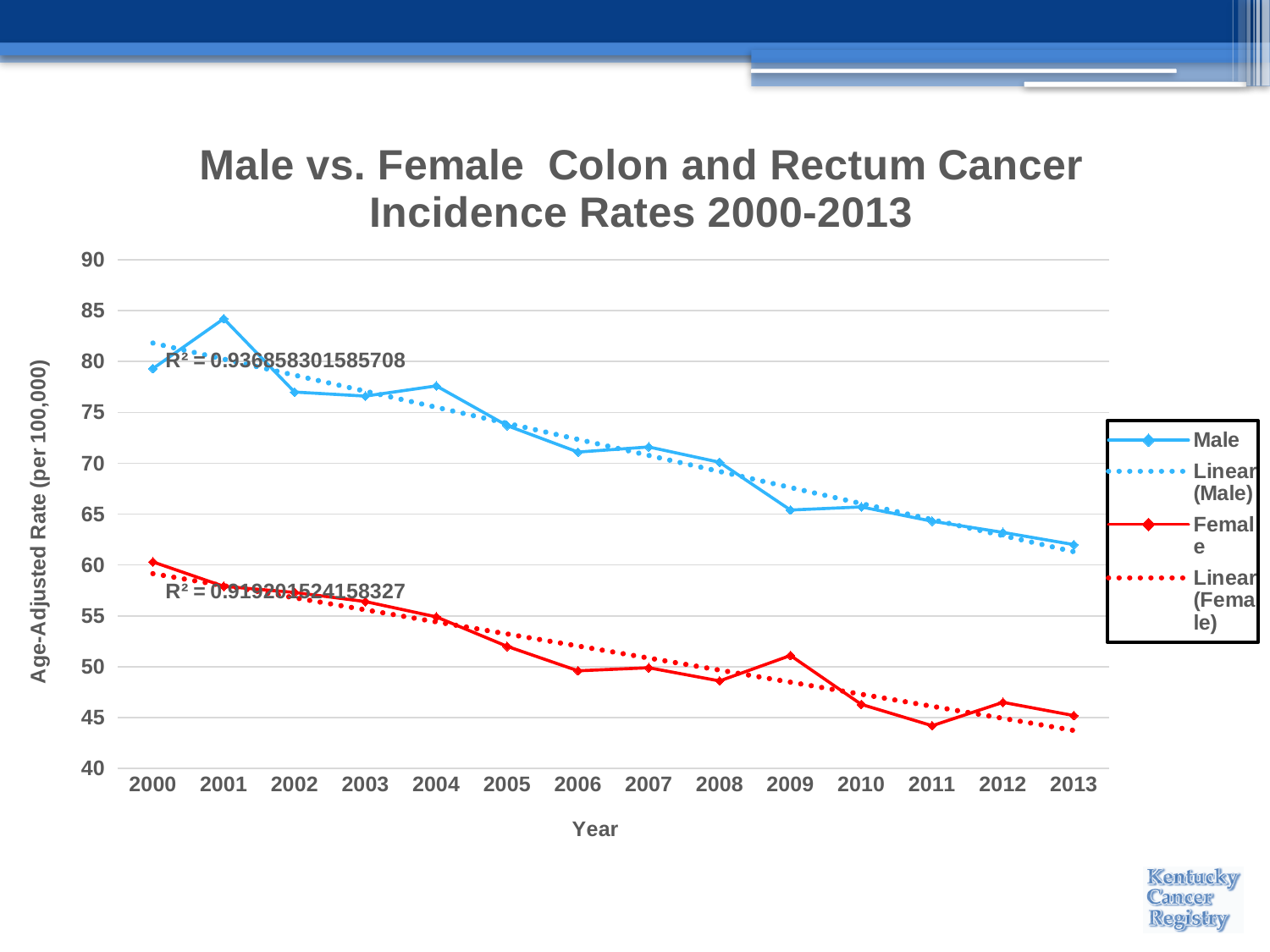
In which year is the Female incidence rate highest? 2000 Is the Female value for 2005 greater or less than 50? greater Do the Male incidence rates generally rise or fall from 2000 to 2013? Fall Is the Female value for 2011 greater or less than 45? less Is the Male value for 2005 greater or less than 75? less Which series has the higher value in 2000, Male or Female? Male In which year is the Male incidence rate lowest? 2013 In which year is the Male incidence rate highest? 2001 How many years are plotted along the x axis? 14 What kind of chart is shown on the slide? Line chart How many entries does the legend list? 4